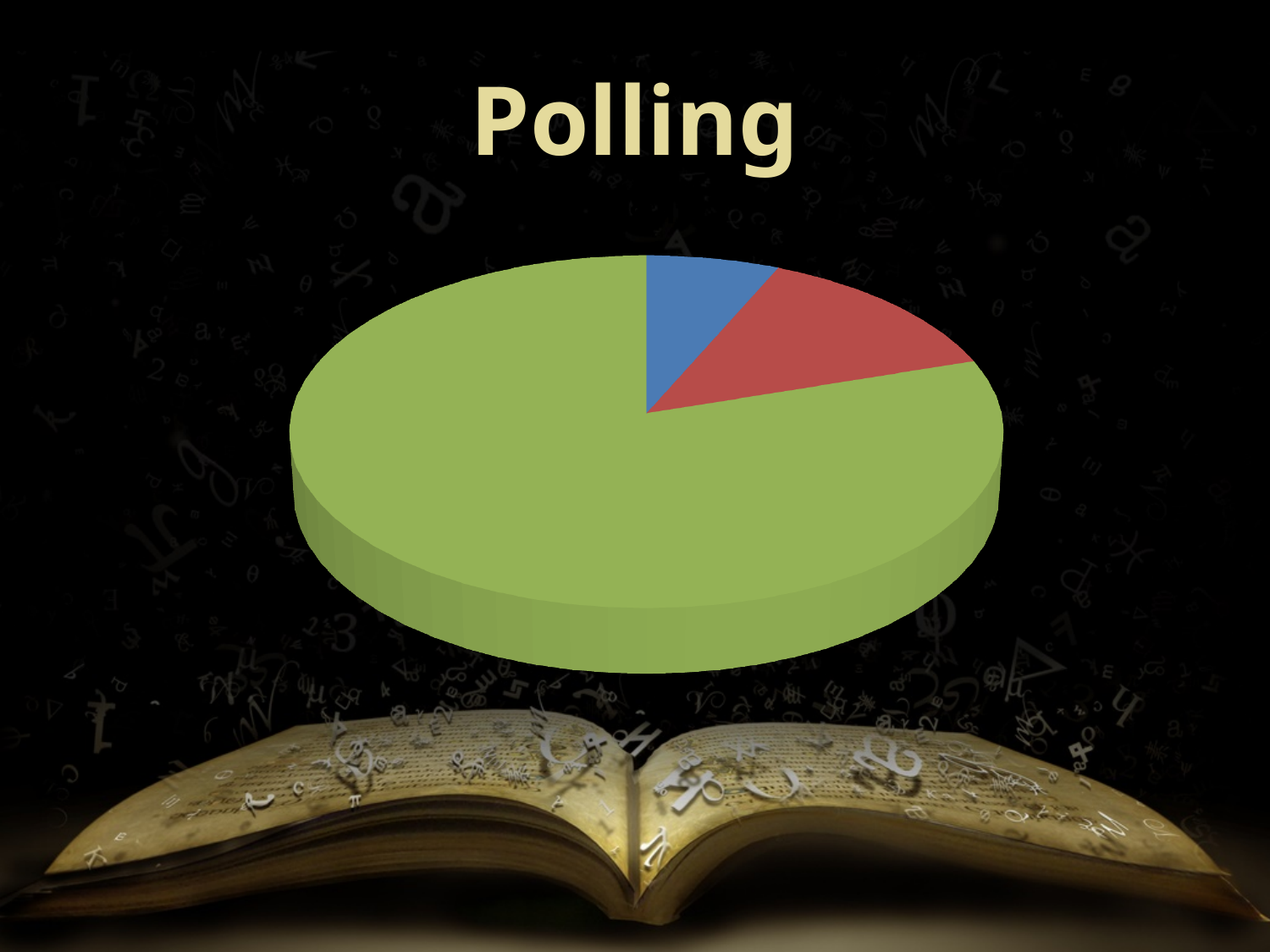
What is the title of the slide containing the pie chart? Polling Which slice is larger, the red slice or the blue slice? red How many slices does the pie chart have? 3 Which slice is larger, the green slice or the red slice? green Which colour slice is the largest in the pie chart? green Which colour slice is the smallest in the pie chart? blue What kind of chart is shown on the slide? pie chart Does the pie chart display a legend? No